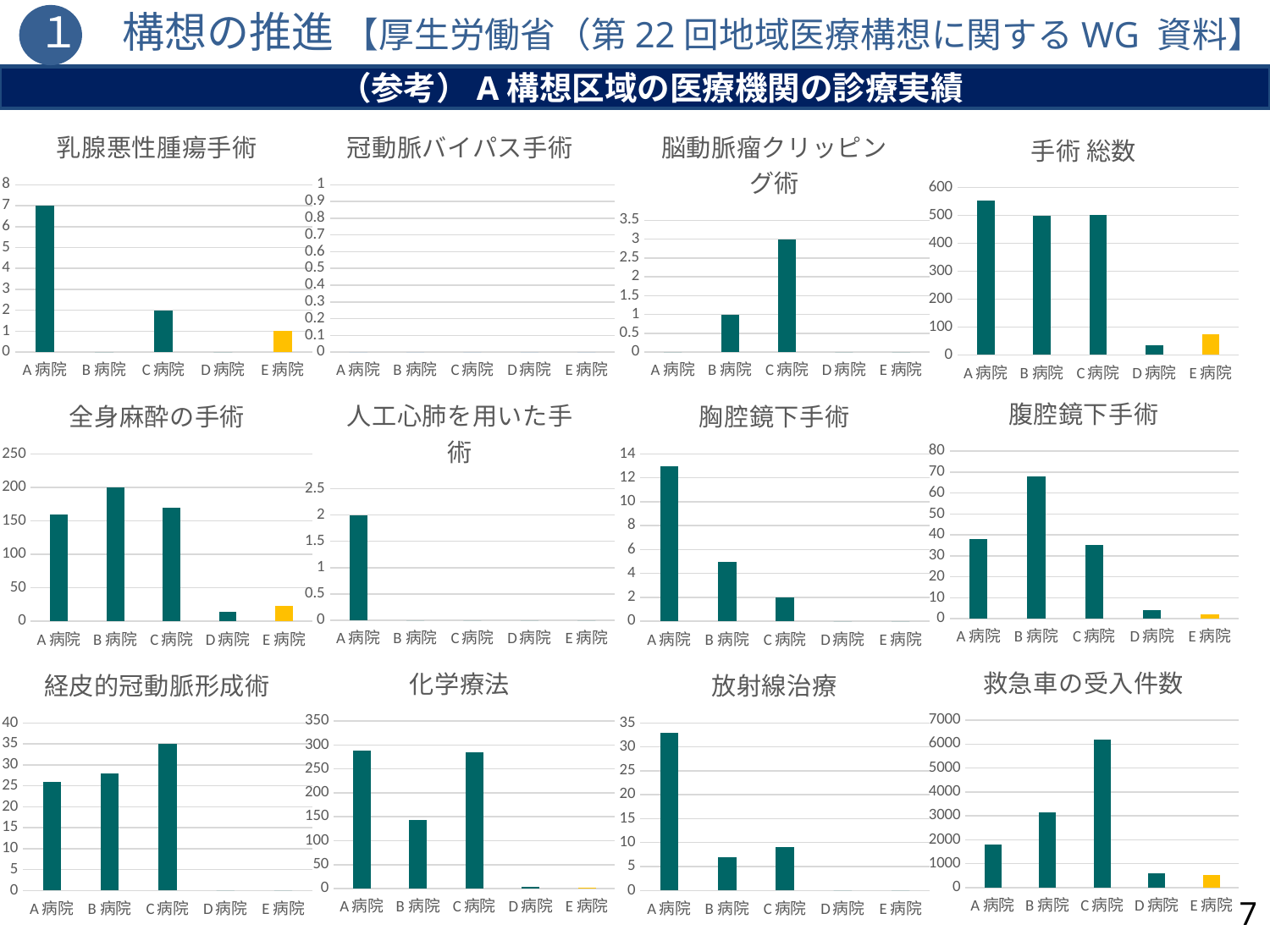
In the 人工心肺を用いた手術 chart, what is the value for A病院? 2 How many hospitals are shown on the x axis of the 放射線治療 chart? 5 In the 胸腔鏡下手術 chart, is the value for A病院 greater or less than 12? greater In the 腹腔鏡下手術 chart, which is larger, B病院 or C病院? B病院 In the 経皮的冠動脈形成術 chart, what is the value for C病院? 35 In the 乳腺悪性腫瘍手術 chart, what is the value for A病院? 7 In the 手術 総数 chart, is the value for A病院 greater or less than 500? greater In the 乳腺悪性腫瘍手術 chart, which hospital has the highest value? A病院 In the 脳動脈瘤クリッピング術 chart, what is the difference between C病院 and B病院? 2 In the 全身麻酔の手術 chart, which hospital has the highest value? B病院 In the 救急車の受入件数 chart, is the value for C病院 greater or less than 6000? greater In the 脳動脈瘤クリッピング術 chart, what is the value for C病院? 3